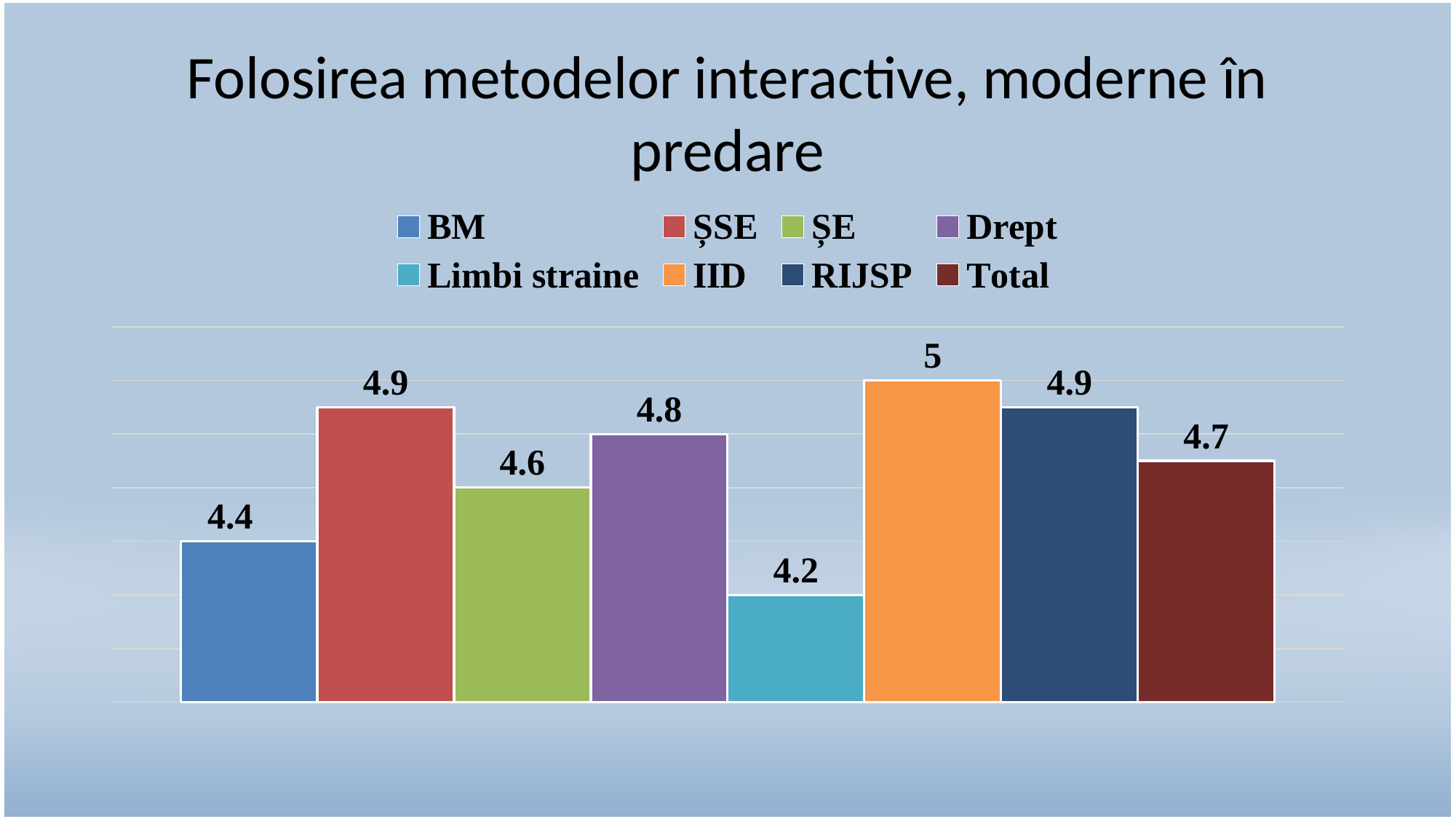
What is the value for IID? 5 What kind of chart is shown on the slide? bar chart Which series has the lowest value? Limbi straine What is the difference between the values for Drept and ȘE? 0.2 Which series has the highest value? IID What is the value for Limbi straine? 4.2 How many series does the legend list? 8 What is the difference between the values for IID and Limbi straine? 0.8 What is the value for BM? 4.4 What is the value for Total? 4.7 What is the title of the chart? Folosirea metodelor interactive, moderne în predare Which is larger, the value for ȘSE or the value for BM? ȘSE